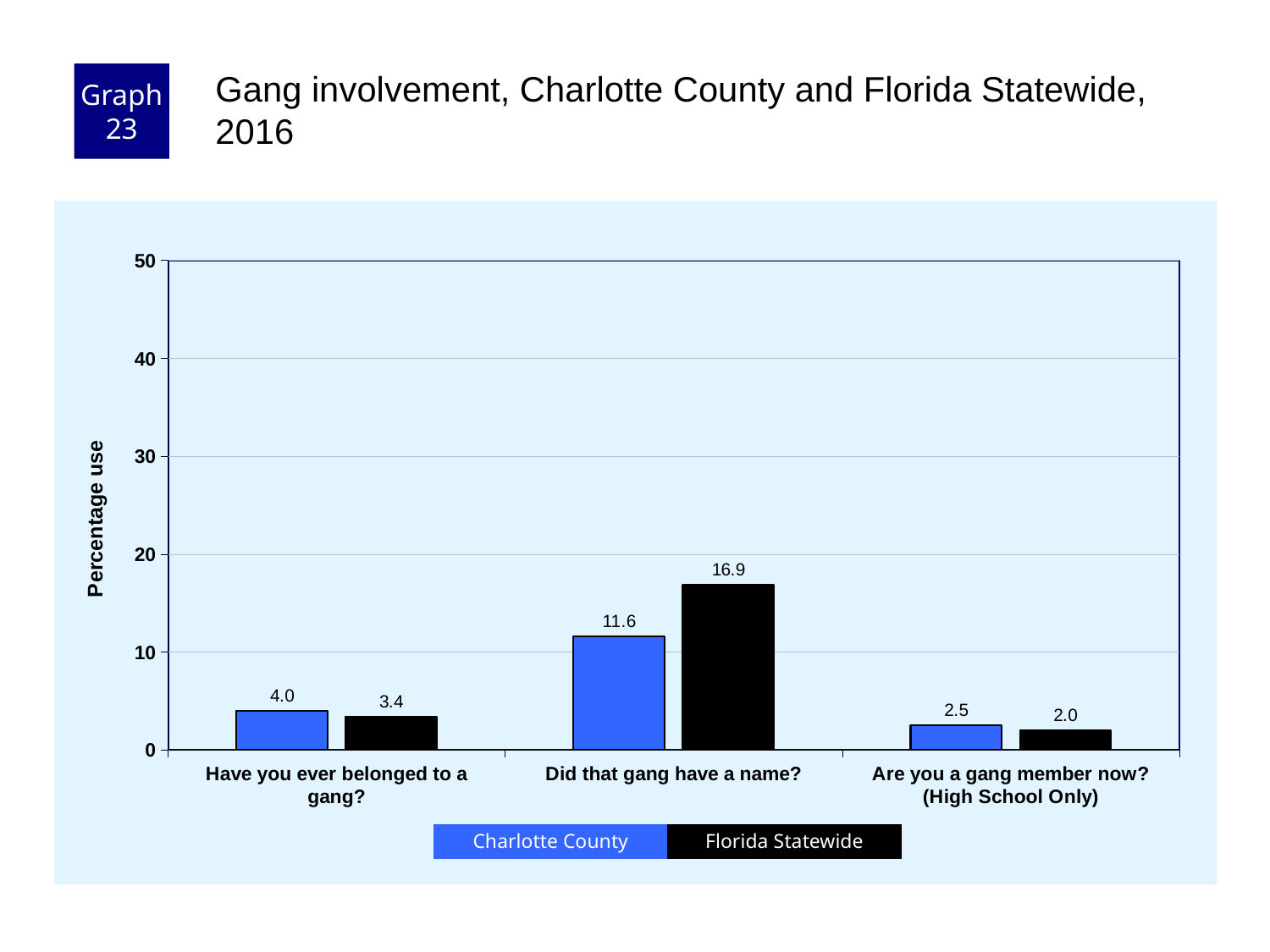
For "Are you a gang member now? (High School Only)", which is larger: Charlotte County or Florida Statewide? Charlotte County Which question has the lowest Charlotte County value? Are you a gang member now? (High School Only) What is the Florida Statewide value for "Did that gang have a name?"? 16.9 How many question categories are shown on the x axis? 3 What is the difference between the Florida Statewide and Charlotte County values for "Did that gang have a name?"? 5.3 What is the Charlotte County value for "Have you ever belonged to a gang?"? 4.0 How many series does the legend list? 2 Which question has the highest Florida Statewide value? Did that gang have a name? What is the Charlotte County value for "Are you a gang member now? (High School Only)"? 2.5 Is the Florida Statewide value for "Did that gang have a name?" greater or less than 20? less What kind of chart is shown on the slide? bar chart What is the Florida Statewide value for "Have you ever belonged to a gang?"? 3.4